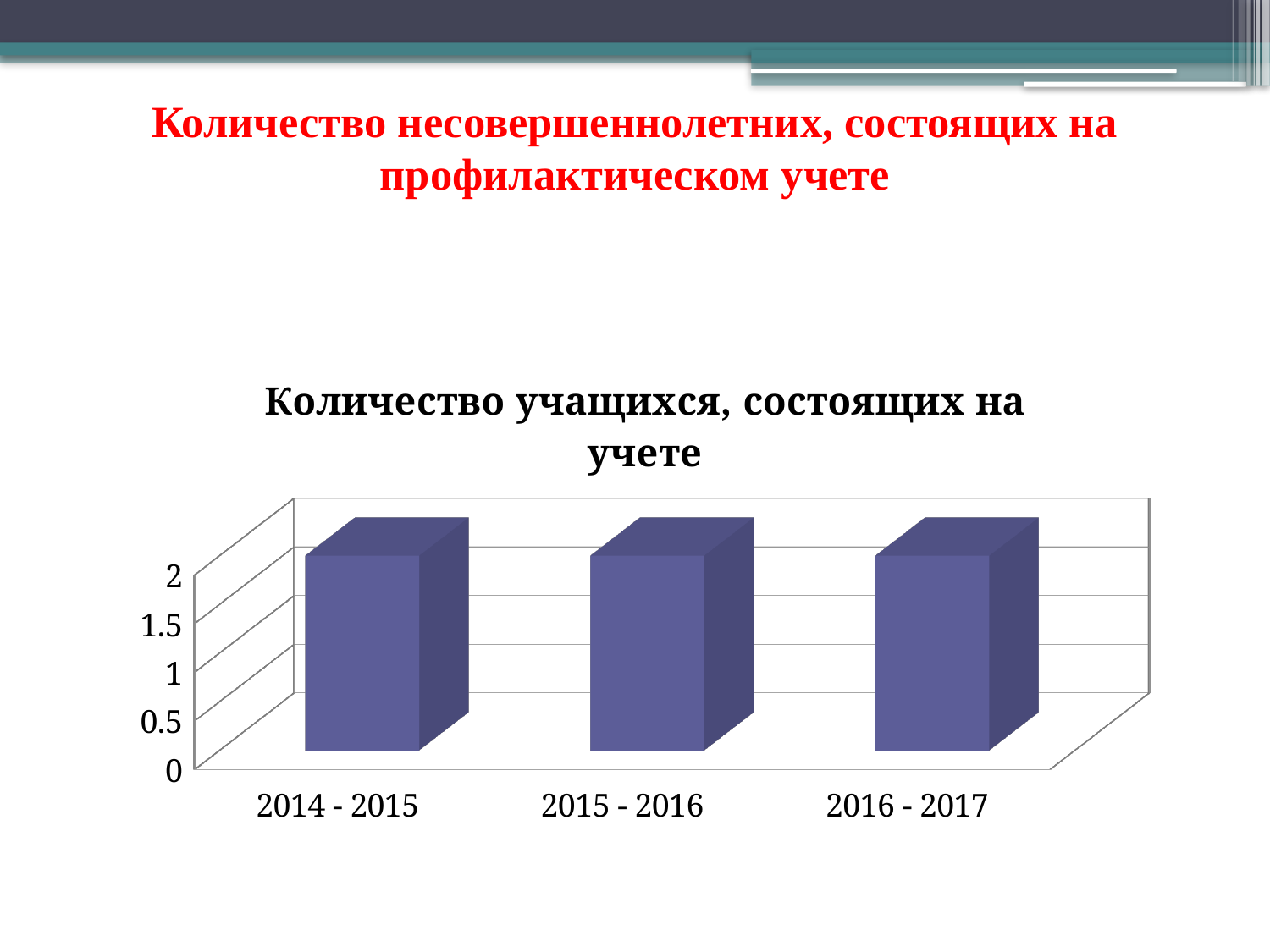
What is the value for 2014 - 2015? 2 Do the values rise, fall, or stay the same from 2014 - 2015 to 2016 - 2017? stay the same Is the value for 2014 - 2015 greater or less than 1? greater How many categories are shown on the x axis of the chart? 3 What is the highest value shown on the vertical axis? 2 Which category is labelled first on the x axis? 2014 - 2015 What kind of chart is shown on the slide? bar chart What is the title of the chart? Количество учащихся, состоящих на учете Is the value for 2016 - 2017 greater or less than 0.5? greater Is the value for 2015 - 2016 greater or less than 1.5? greater What is the value for 2016 - 2017? 2